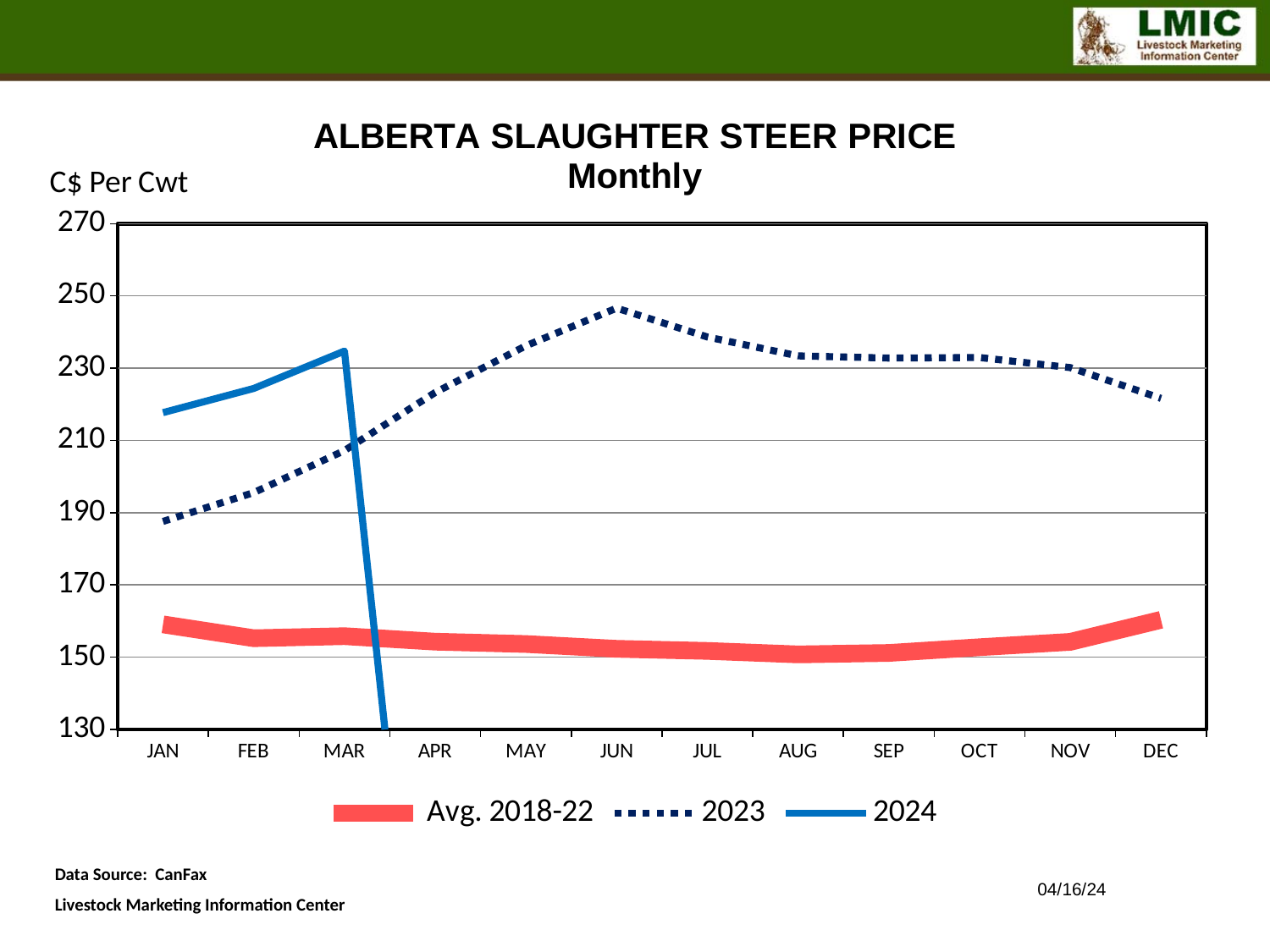
Does the 2024 series rise or fall from JAN to MAR? rise In which month does the 2023 series reach its highest value? JUN What is the title of the chart? ALBERTA SLAUGHTER STEER PRICE Monthly In which month does the 2023 series have its lowest value? JAN What kind of chart is shown on the slide? line chart How many series does the legend list? 3 Is the value for 2024 in MAR greater or less than 230? greater Is the value for 2023 in JUN greater or less than 230? greater Is the value for Avg. 2018-22 in AUG greater or less than 170? less What unit label is shown on the y axis? C$ Per Cwt How many months are shown along the x axis? 12 Which is larger in JAN, the 2024 value or the 2023 value? 2024